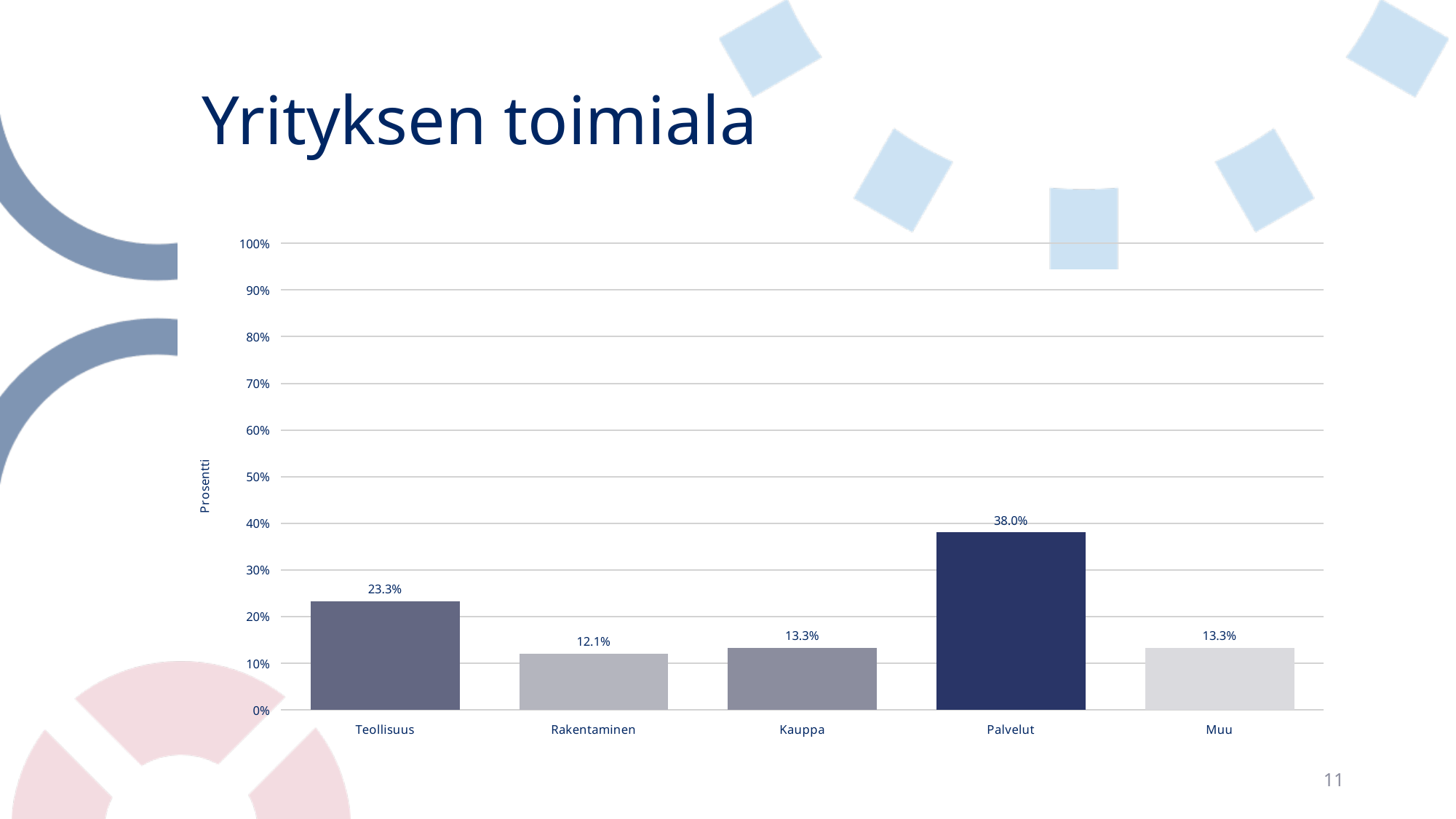
How many categories are shown on the x axis? 5 Which category has the lowest value? Rakentaminen Which is larger, the value for Teollisuus or the value for Muu? Teollisuus Is the value for Palvelut greater or less than 30%? greater What is the difference between the values for Palvelut and Teollisuus? 14.7% Which category has the highest value? Palvelut What kind of chart is shown on the slide? bar chart What is the value for Rakentaminen? 12.1% What is the title of the slide? Yrityksen toimiala What is the value for Teollisuus? 23.3% What is the value for Palvelut? 38.0% What is the difference between the values for Kauppa and Rakentaminen? 1.2%